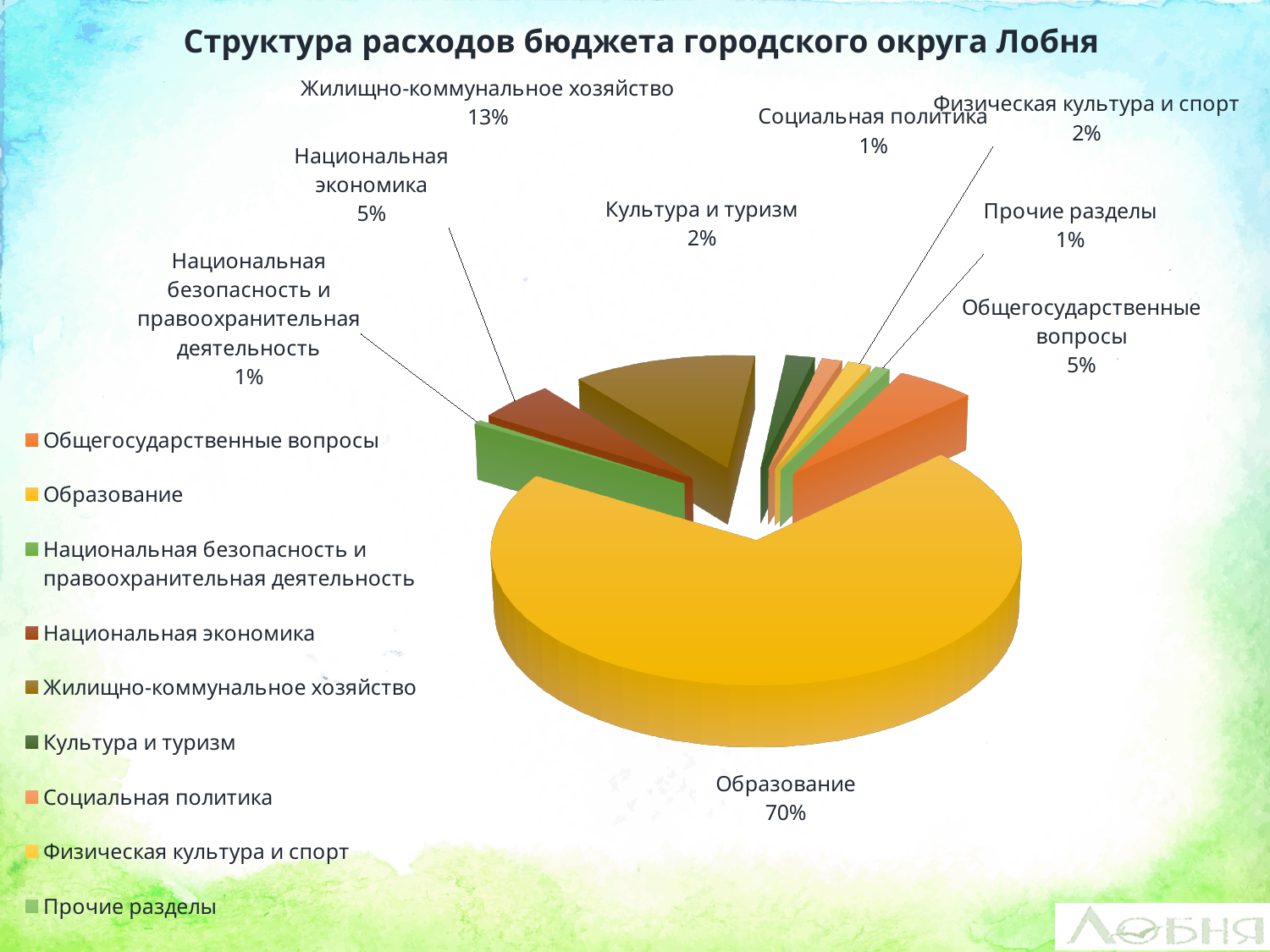
What percentage is shown for Жилищно-коммунальное хозяйство? 13% What share of the budget expenditure goes to Образование? 70% What type of chart is shown on the slide? pie chart What percentage is shown for Социальная политика? 1% What is the difference in percentage points between Образование and Жилищно-коммунальное хозяйство? 57 How many categories does the pie chart contain? 9 What is the combined share of Национальная экономика and Общегосударственные вопросы? 10% Which is larger: the share for Жилищно-коммунальное хозяйство or the share for Общегосударственные вопросы? Жилищно-коммунальное хозяйство Which category has the largest share of the pie? Образование What is the title of the chart? Структура расходов бюджета городского округа Лобня What percentage is shown for Физическая культура и спорт? 2% What percentage is shown for Национальная экономика? 5%